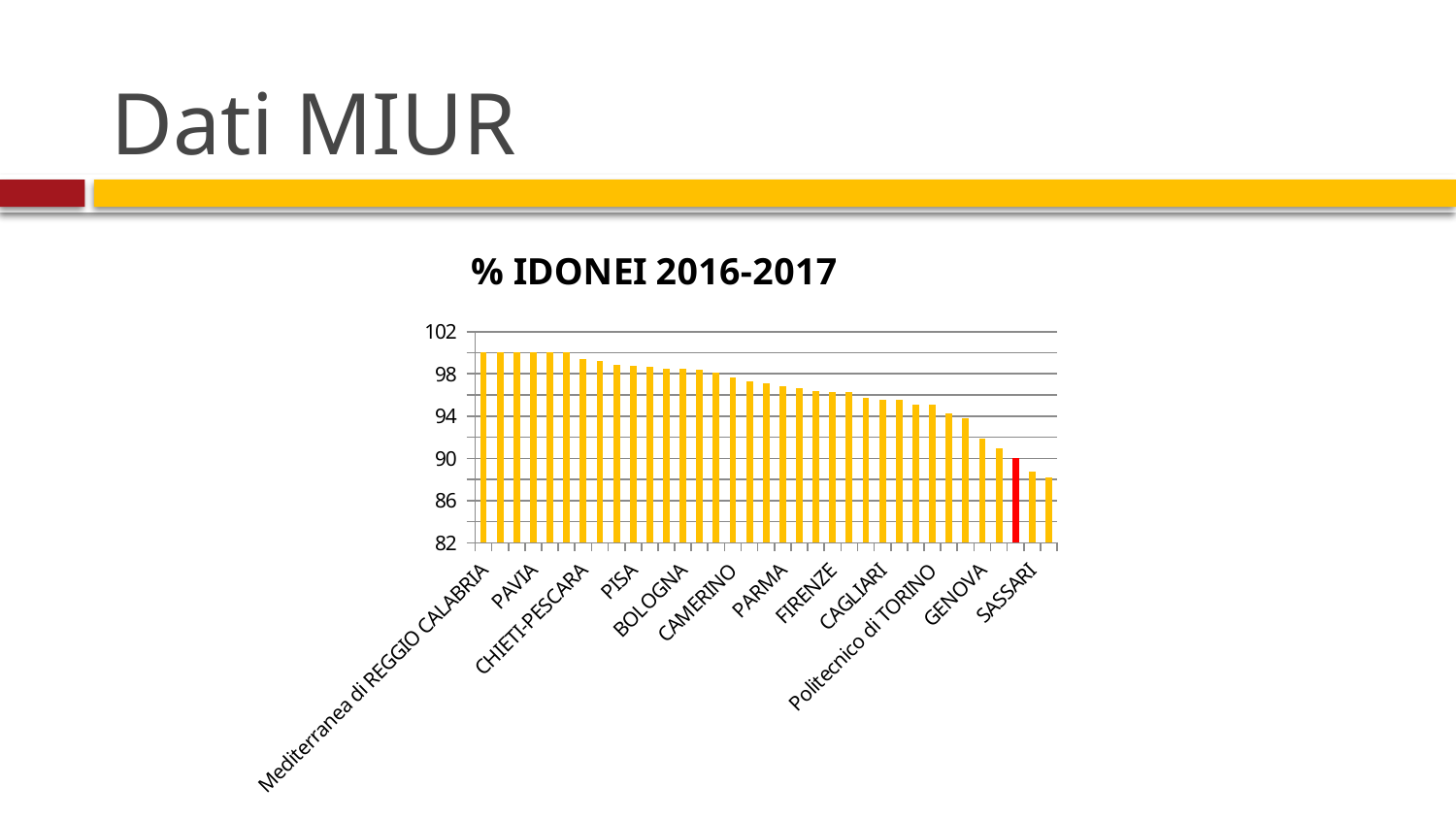
Is the value for FIRENZE greater or less than 98? less Is the value for Politecnico di TORINO greater or less than 94? greater Is the value for SASSARI greater or less than 90? less What colour is the single highlighted bar near the right end of the chart? red Do the values rise or fall moving from left to right along the x axis? fall What kind of chart is shown on the slide? bar chart Which has the larger value, PAVIA or GENOVA? PAVIA What is the title of the chart? % IDONEI 2016-2017 Which has the larger value, Mediterranea di REGGIO CALABRIA or SASSARI? Mediterranea di REGGIO CALABRIA